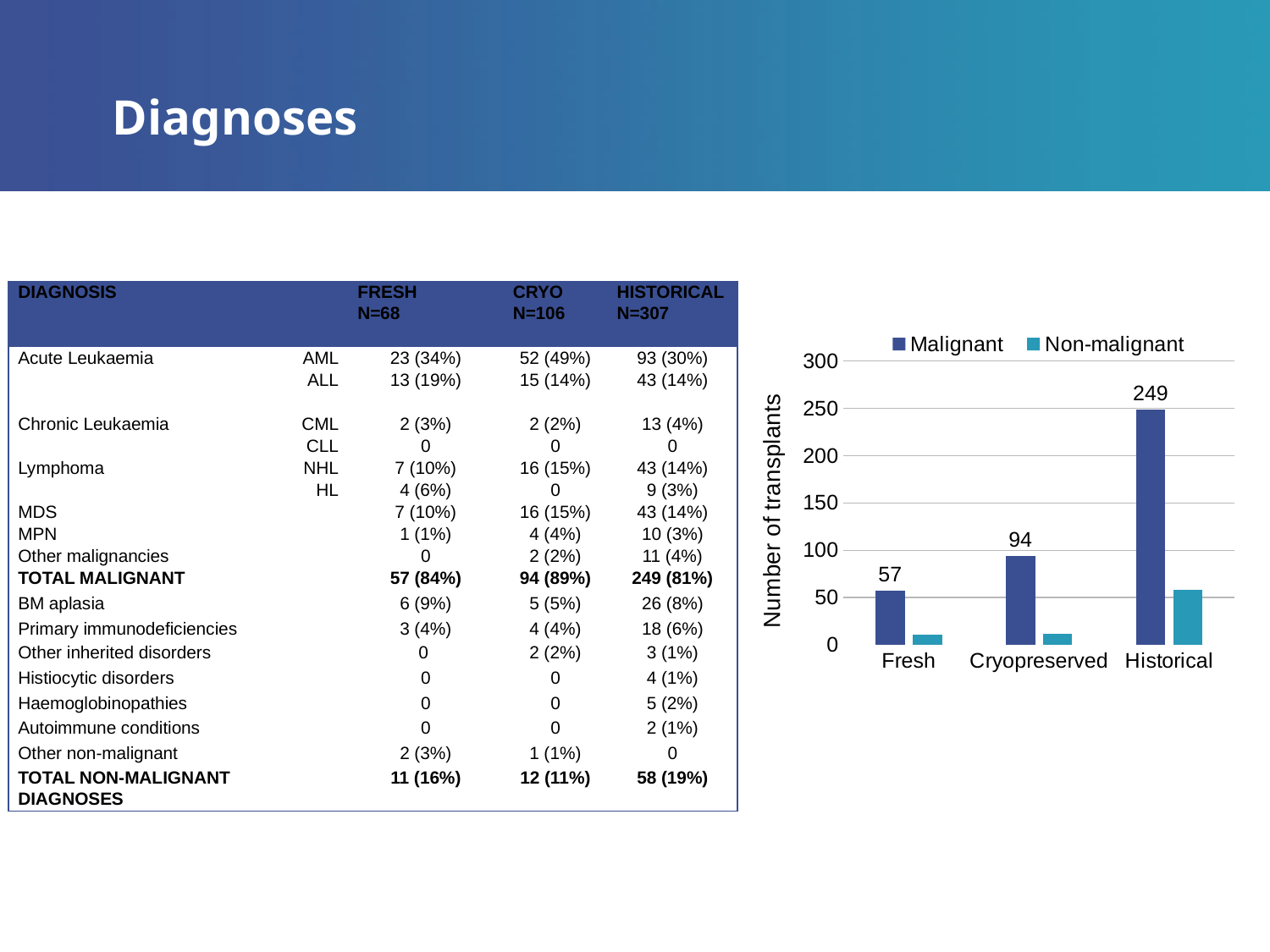
Which category has the highest Malignant value? Historical Which category has the lowest Malignant value? Fresh How many series does the chart legend list? 2 What is the difference between the Malignant values for Historical and Cryopreserved? 155 How many categories are shown on the x axis of the chart? 3 What is the number of Malignant transplants for Cryopreserved? 94 What is the number of Malignant transplants for Historical? 249 Which is larger, the Malignant value for Cryopreserved or for Fresh? Cryopreserved Is the Non-malignant value for Fresh greater or less than 50? less What type of chart is shown on the slide? bar chart What is the label on the y axis of the chart? Number of transplants What is the number of Malignant transplants for Fresh? 57